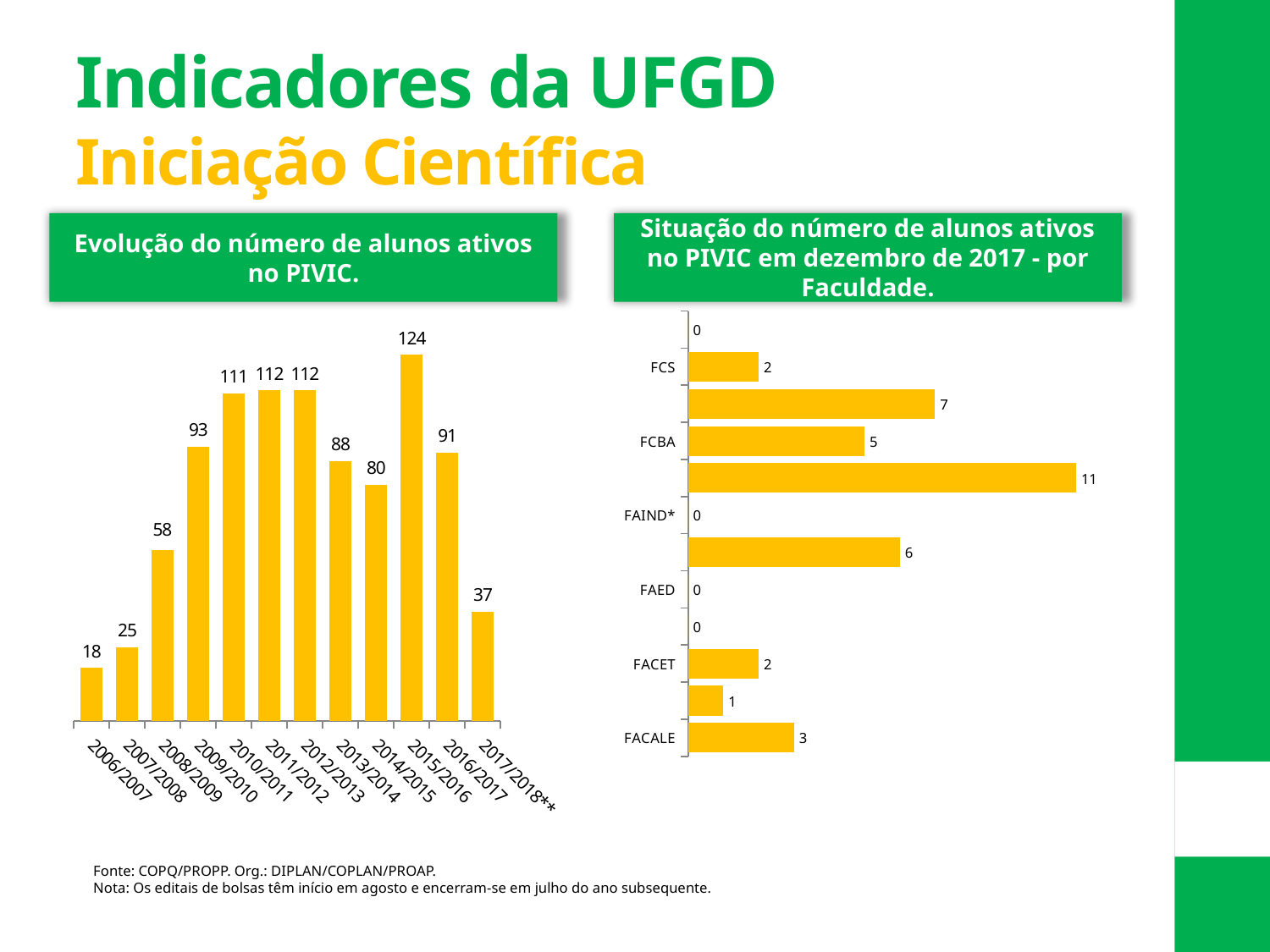
In the chart 'Situação do número de alunos ativos no PIVIC em dezembro de 2017 - por Faculdade', what is the value for FACALE? 3 In the chart 'Evolução do número de alunos ativos no PIVIC', what is the difference between the values for 2015/2016 and 2016/2017? 33 What type of chart is 'Evolução do número de alunos ativos no PIVIC'? Bar chart In the chart 'Situação do número de alunos ativos no PIVIC em dezembro de 2017 - por Faculdade', which is larger: the value for FCS or FCBA? FCBA In the chart 'Evolução do número de alunos ativos no PIVIC', which period has the lowest value? 2006/2007 In the chart 'Evolução do número de alunos ativos no PIVIC', which period has the highest value? 2015/2016 In the chart 'Evolução do número de alunos ativos no PIVIC', which is larger: the value for 2013/2014 or 2014/2015? 2013/2014 In the chart 'Situação do número de alunos ativos no PIVIC em dezembro de 2017 - por Faculdade', what is the value for FAED? 0 How many periods are shown in the chart 'Evolução do número de alunos ativos no PIVIC'? 12 In the chart 'Evolução do número de alunos ativos no PIVIC', what is the value for 2015/2016? 124 In the chart 'Situação do número de alunos ativos no PIVIC em dezembro de 2017 - por Faculdade', what is the value for FCBA? 5 In the chart 'Evolução do número de alunos ativos no PIVIC', what is the value for 2006/2007? 18